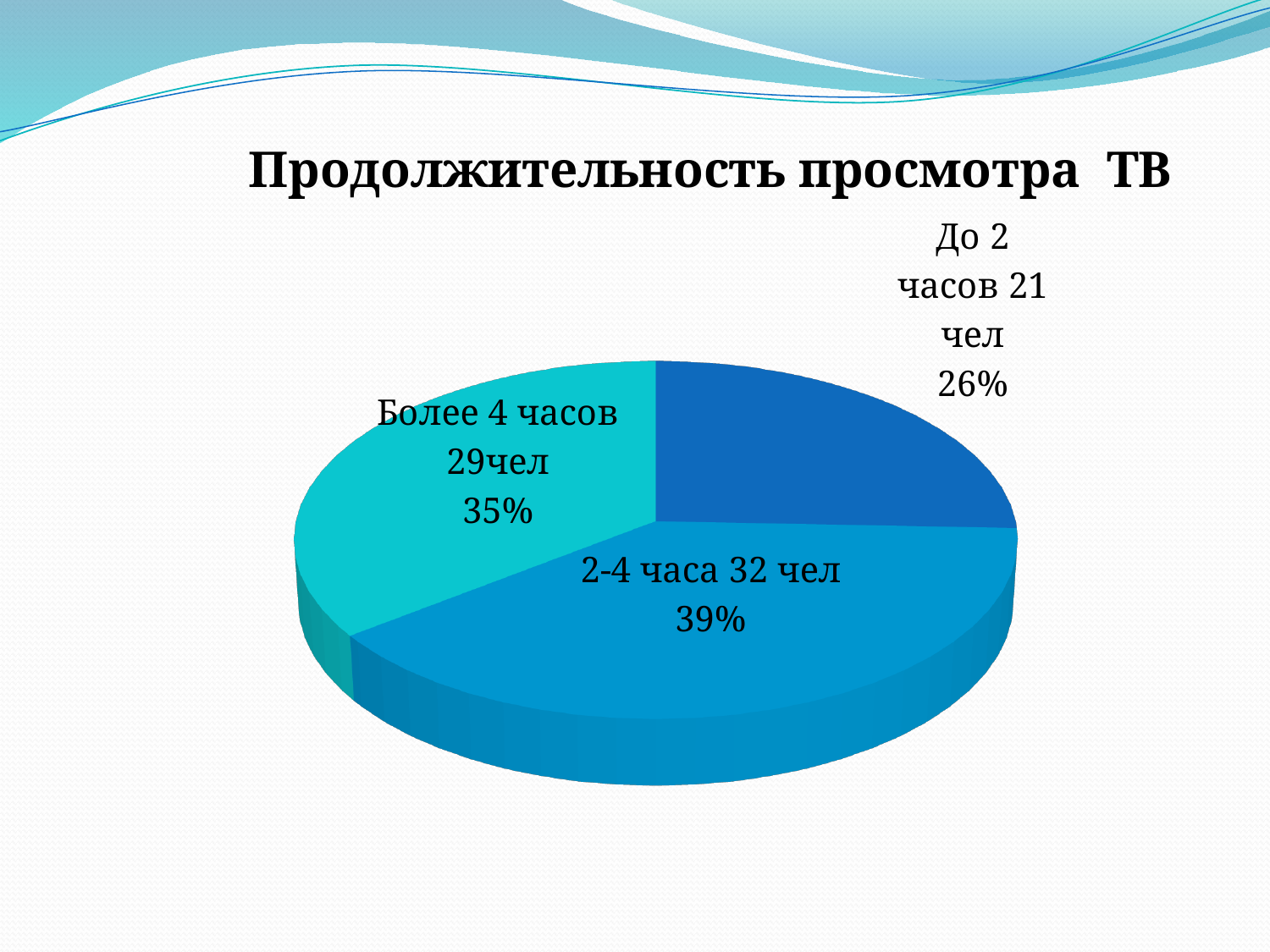
What share of the pie does the "До 2 часов" slice represent? 26% What share of the pie does the "2-4 часа" slice represent? 39% What share of the pie does the "Более 4 часов" slice represent? 35% What is the title of the chart? Продолжительность просмотра ТВ How many people are in the "Более 4 часов" category? 29чел How many slices does the pie chart have? 3 Which category has the smallest share of the pie? До 2 часов What is the difference in people between the "2-4 часа" and "До 2 часов" categories? 11 How many people are in the "2-4 часа" category? 32 чел Which category has the largest share of the pie? 2-4 часа How many people are in the "До 2 часов" category? 21 чел What kind of chart is shown on the slide? pie chart